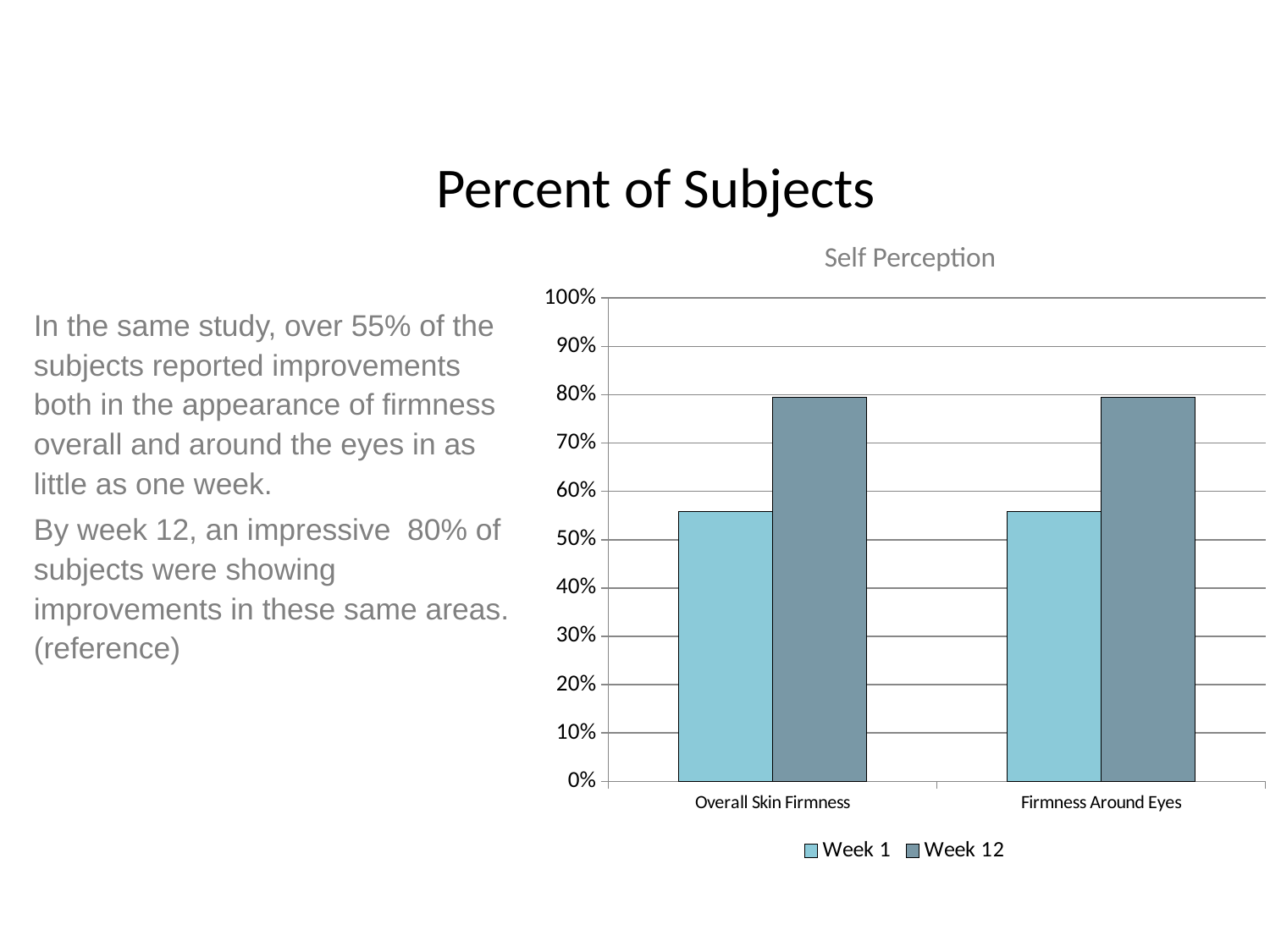
Is the Week 1 value for Overall Skin Firmness greater or less than 50%? greater For Firmness Around Eyes, which series has the lower value? Week 1 For Overall Skin Firmness, which is larger: the Week 1 value or the Week 12 value? Week 12 What kind of chart is shown on the slide? bar chart How many series does the chart legend list? 2 Is the Week 12 value for Firmness Around Eyes greater or less than 70%? greater Is the Week 12 value for Overall Skin Firmness greater or less than 90%? less What are the two series named in the legend? Week 1 and Week 12 What is the title of the chart? Self Perception How many categories are shown on the x axis? 2